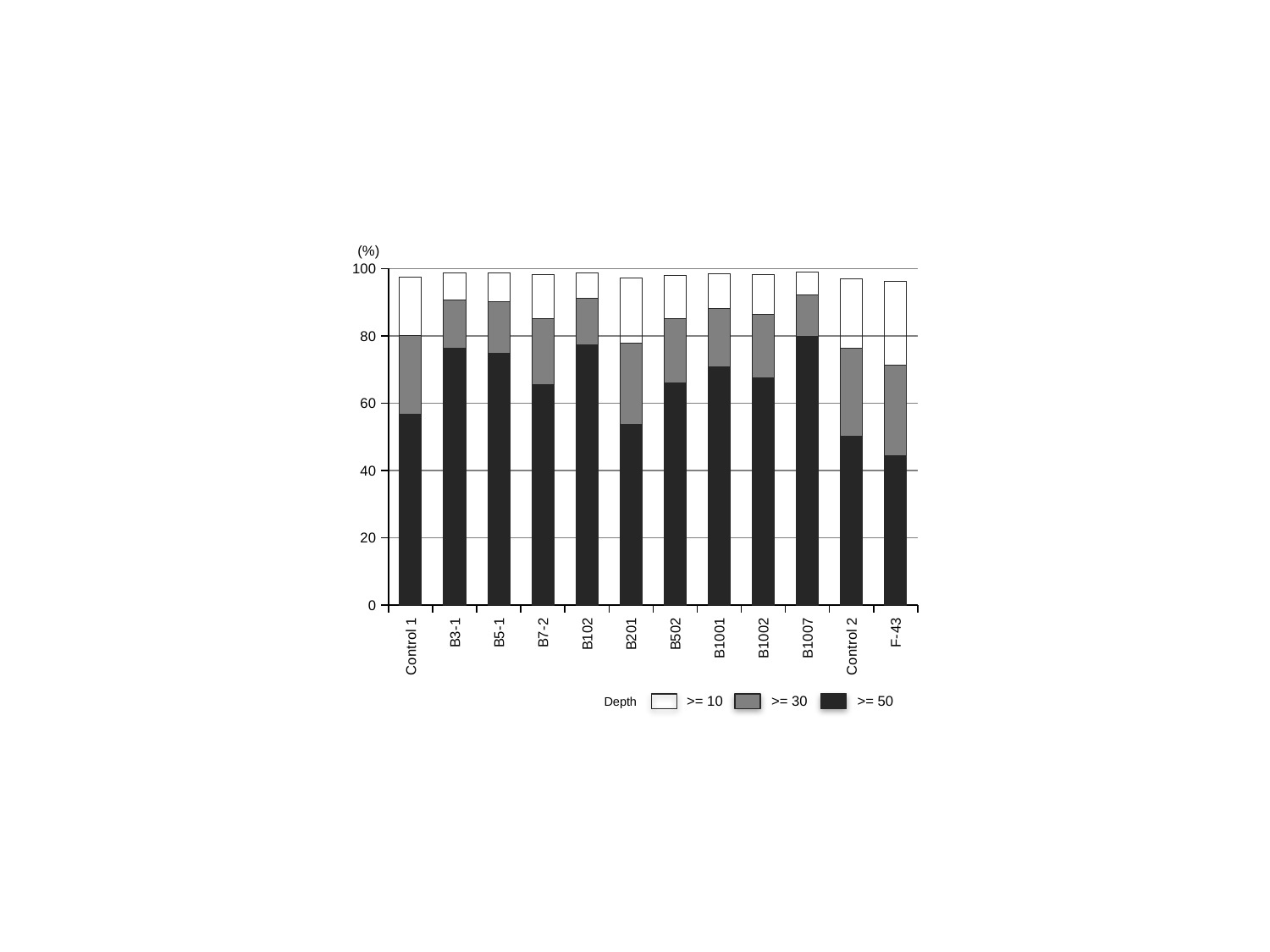
How many series does the legend list? 3 For the >= 50 series, which is larger: B3-1 or B201? B3-1 What unit is shown on the y axis? (%) Is the value for the >= 50 series for B201 greater or less than 60? less What kind of chart is shown on the slide? bar chart How many categories are shown along the x axis? 12 For the >= 50 series, which is larger: Control 1 or B1001? B1001 Is the value for the >= 50 series for B3-1 greater or less than 60? greater Is the value for the >= 50 series for F-43 greater or less than 60? less What is the title of the legend? Depth Which category has the lowest value for the >= 50 series? F-43